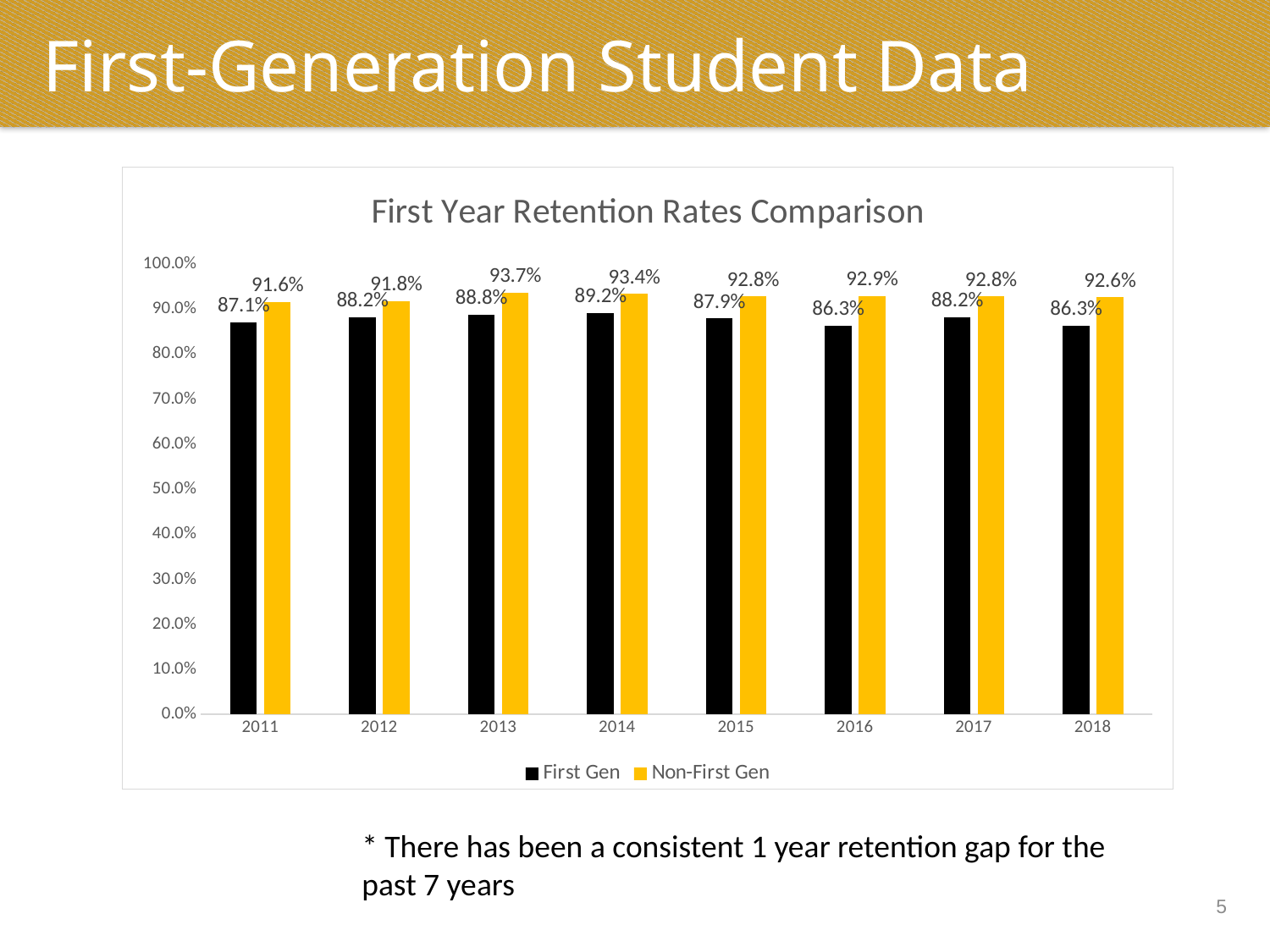
Which year has the highest First Gen retention rate? 2014 What is the First Gen retention rate for 2018? 86.3% What type of chart is shown? Bar chart Which year has the lowest Non-First Gen retention rate? 2011 Which year has the highest Non-First Gen retention rate? 2013 What is the First Gen retention rate for 2014? 89.2% What is the difference between the Non-First Gen and First Gen retention rates in 2016? 6.6% How many years are shown on the x axis? 8 How many series does the legend list? 2 In 2015, which group has the higher retention rate, First Gen or Non-First Gen? Non-First Gen What is the difference between the Non-First Gen and First Gen retention rates in 2011? 4.5% What is the Non-First Gen retention rate for 2013? 93.7%